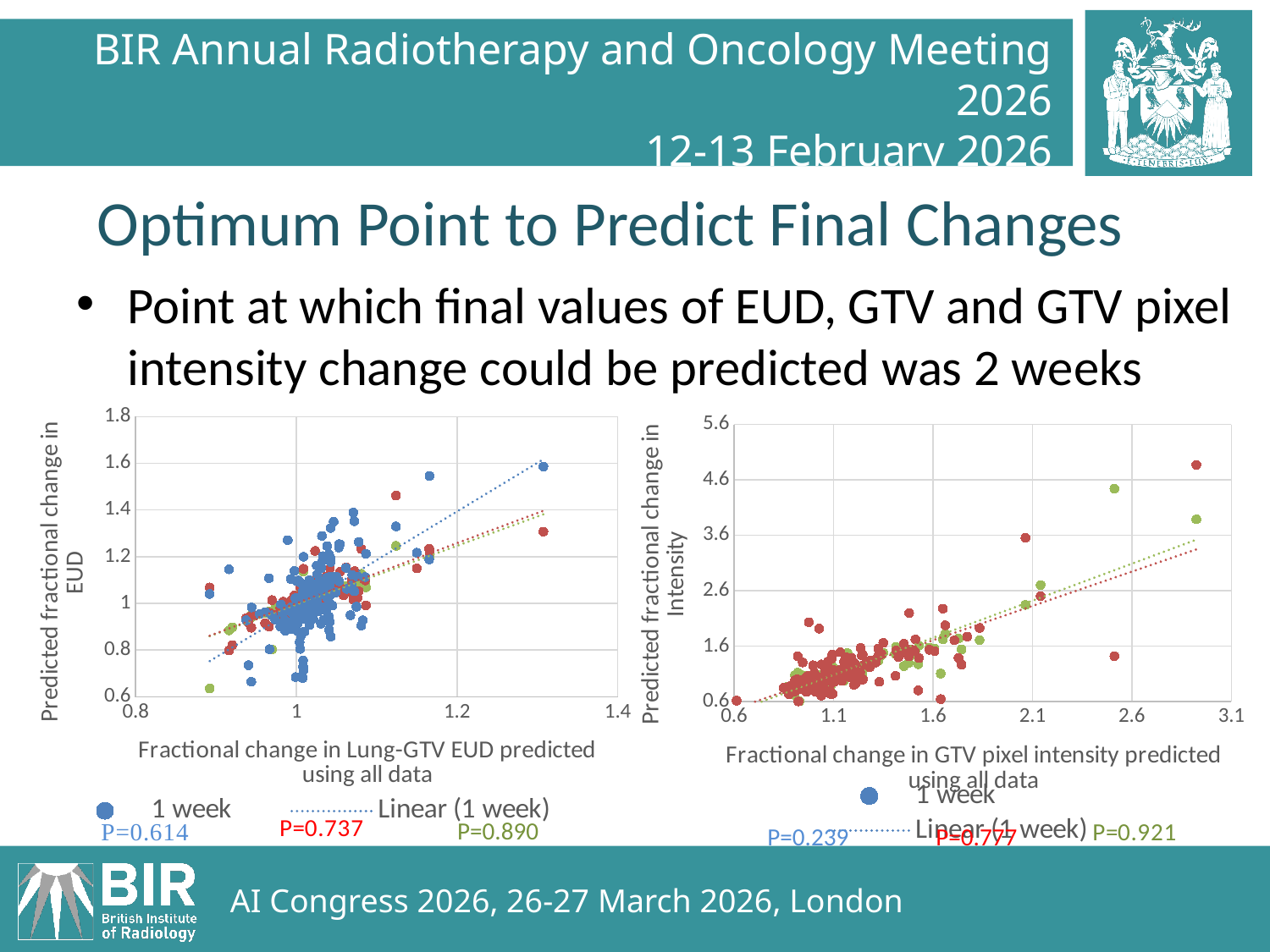
In the right chart, is the highest plotted point greater or less than 4.6 on the y-axis? greater What kind of chart is the left chart on the slide? Scatter chart What is the maximum value shown on the y-axis of the right chart? 5.6 What is the x-axis title of the left chart? Fractional change in Lung-GTV EUD predicted using all data In the left chart, is the highest plotted point greater or less than 1.4 on the y-axis? greater In the left chart (Predicted fractional change in EUD), do the plotted values generally rise or fall as the x-axis value increases? Rise In the left chart, is the lowest plotted point greater or less than 0.8 on the y-axis? less How many entries does the legend of the left chart list? 2 Which chart has the larger maximum value on its y-axis, the left chart or the right chart? The right chart What kind of chart is the right chart on the slide? Scatter chart In the right chart (Predicted fractional change in Intensity), do the plotted values generally rise or fall as the x-axis value increases? Rise